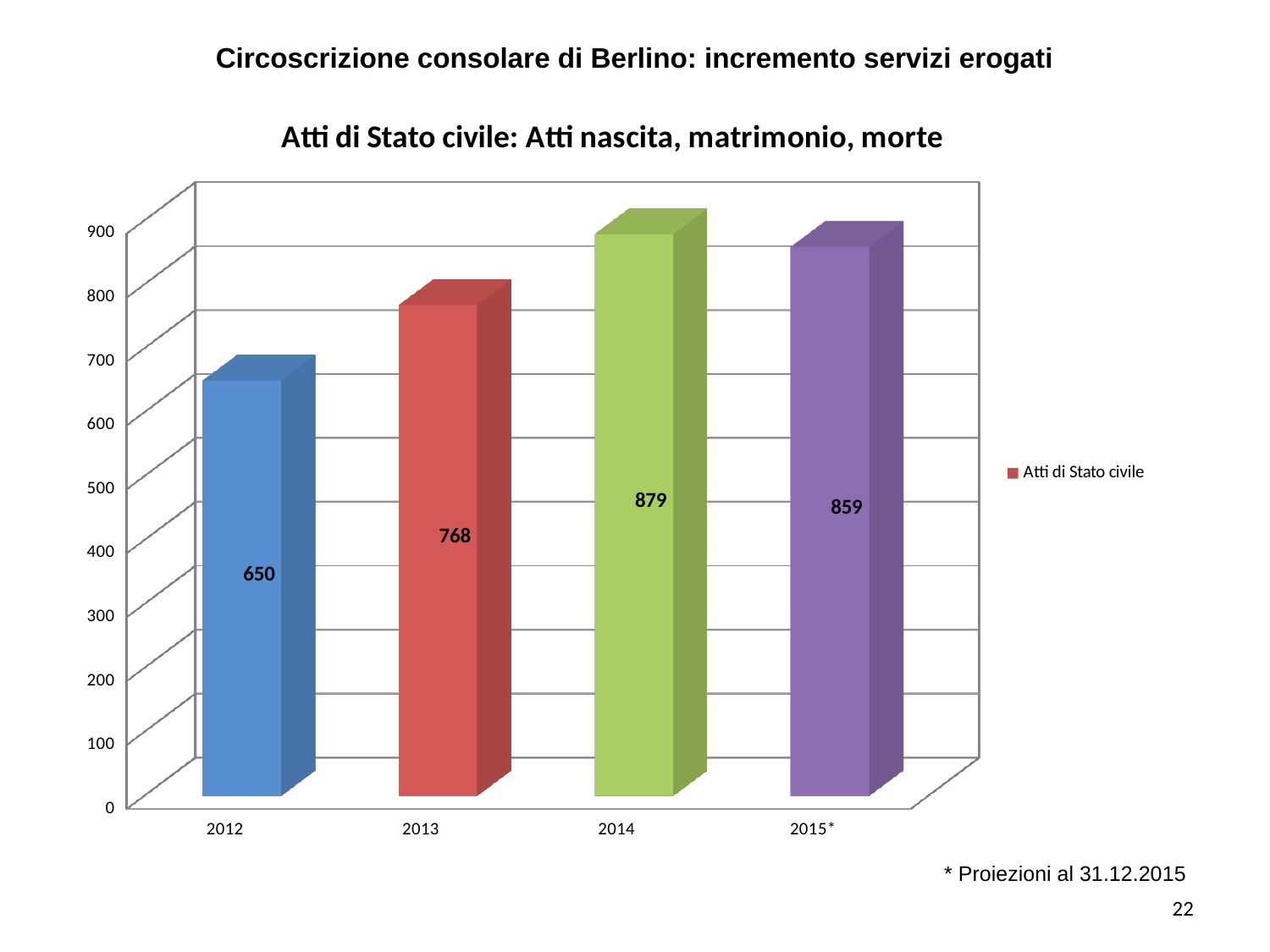
What is the difference between the values for 2013 and 2012? 118 What is the value for 2015*? 859 Is the value for 2013 greater or less than 700? greater Which year has the highest value? 2014 What is the value for 2014? 879 Which year has the lowest value? 2012 How many years are shown on the x axis? 4 Which is larger, the value for 2013 or the value for 2015*? 2015* What is the title of the chart? Atti di Stato civile: Atti nascita, matrimonio, morte What is the value for 2012? 650 What is the difference between the values for 2014 and 2015*? 20 What kind of chart is shown? bar chart